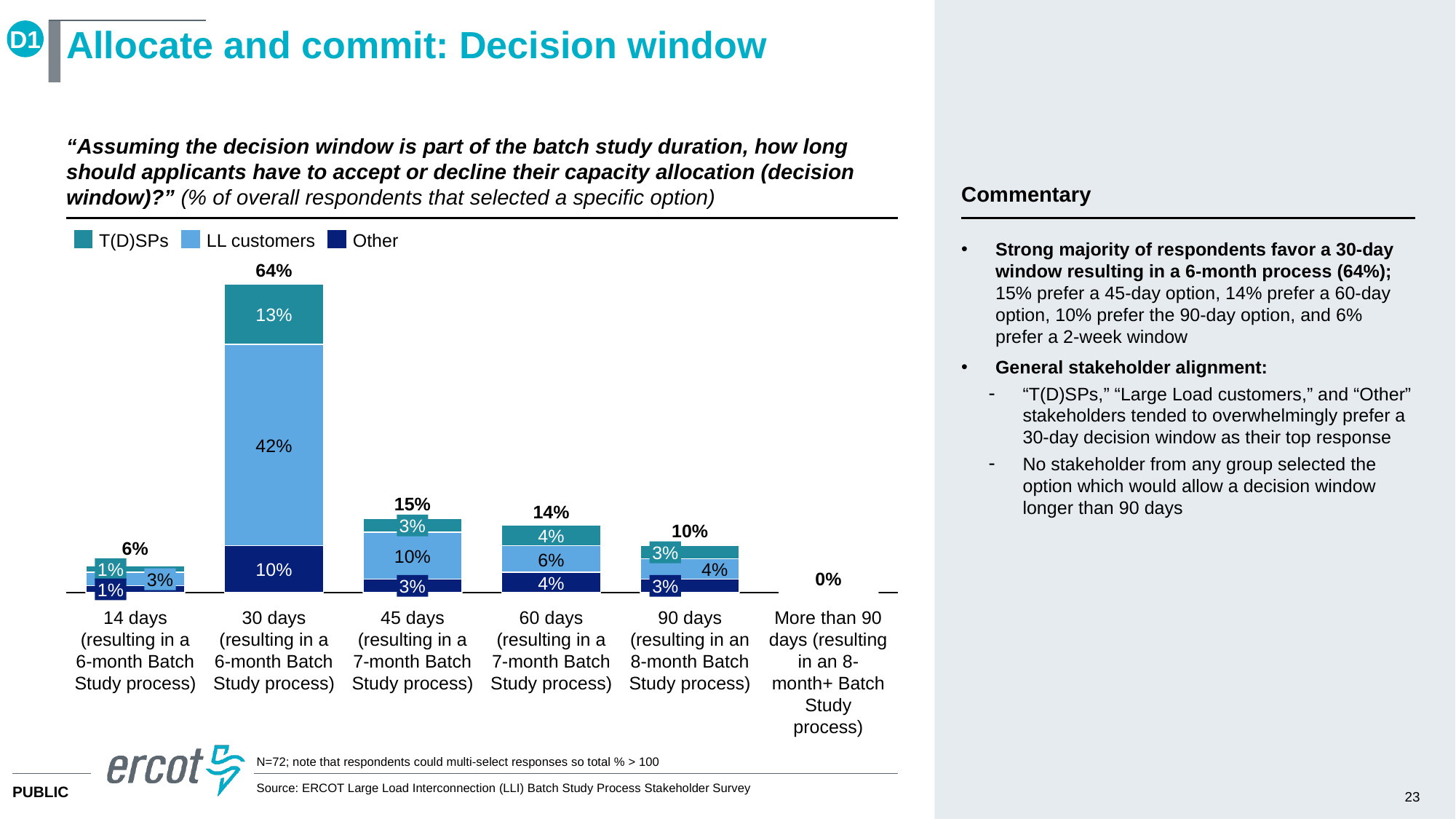
Which is larger: the total for 45 days or the total for 60 days? 45 days Which decision-window option has the lowest total percentage? More than 90 days (resulting in an 8-month+ Batch Study process) What kind of chart is shown on the slide? Stacked bar chart How many decision-window options (categories) are shown on the x axis? 6 Which decision-window option has the highest total percentage? 30 days (resulting in a 6-month Batch Study process) What is the T(D)SPs value for the 60 days option? 4% What is the LL customers value for the 30 days option? 42% How many series does the legend list? 3 Which series is shown in the darkest blue colour in the legend? Other What is the difference between the LL customers value for 30 days and the LL customers value for 45 days? 32 percentage points What is the total percentage shown above the bar for 30 days (resulting in a 6-month Batch Study process)? 64% What is the Other value for the 45 days option? 3%